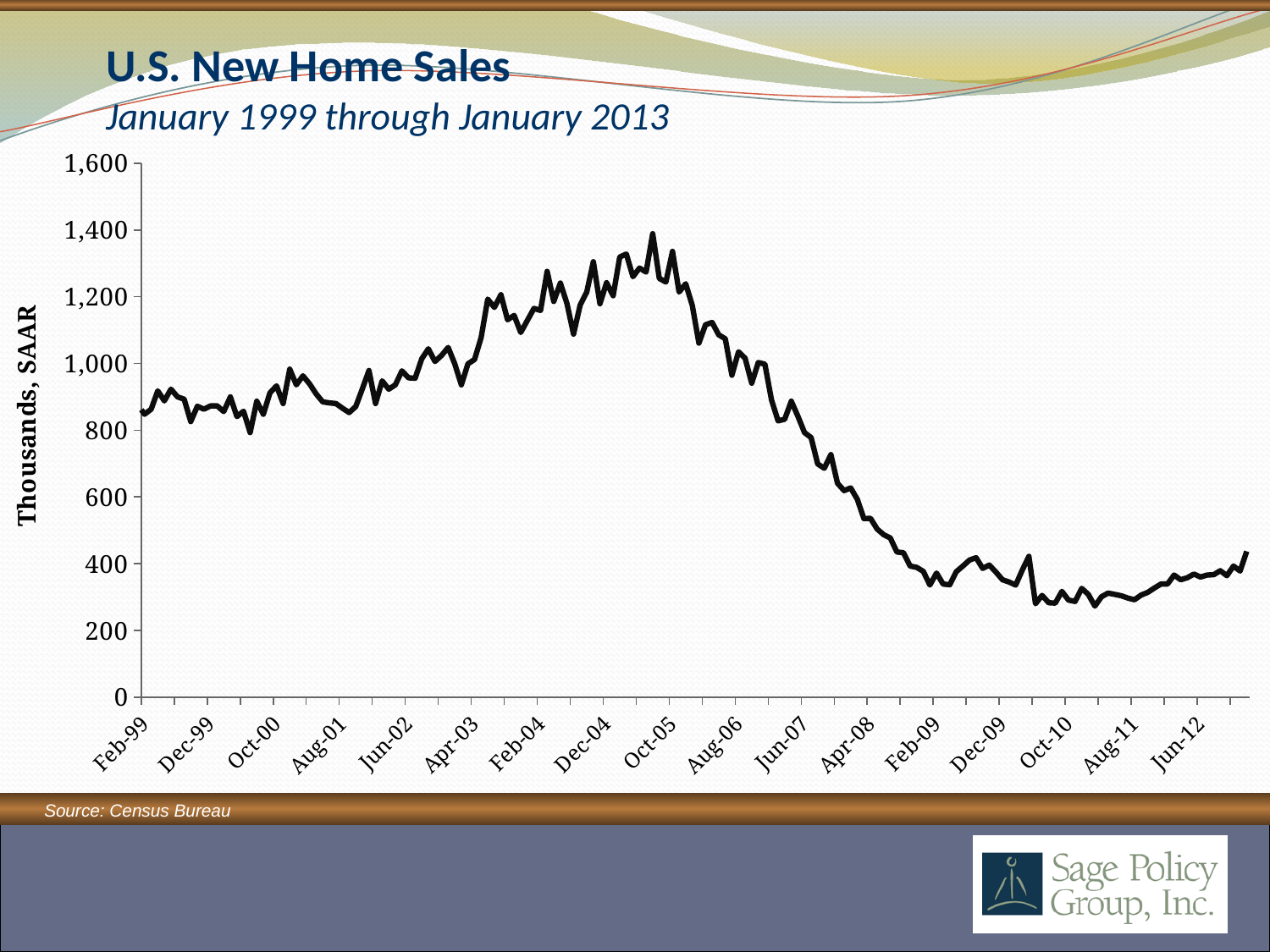
Is the value for Feb-99 greater or less than 800? greater Is the value for Oct-10 greater or less than 400? less Is the value for Dec-04 greater or less than 1,000? greater How many date labels are shown on the horizontal axis? 17 What kind of chart is shown on the slide? line chart What is the title of the chart? U.S. New Home Sales What is the label on the vertical axis? Thousands, SAAR Do the values rise or fall between Oct-05 and Feb-09? fall